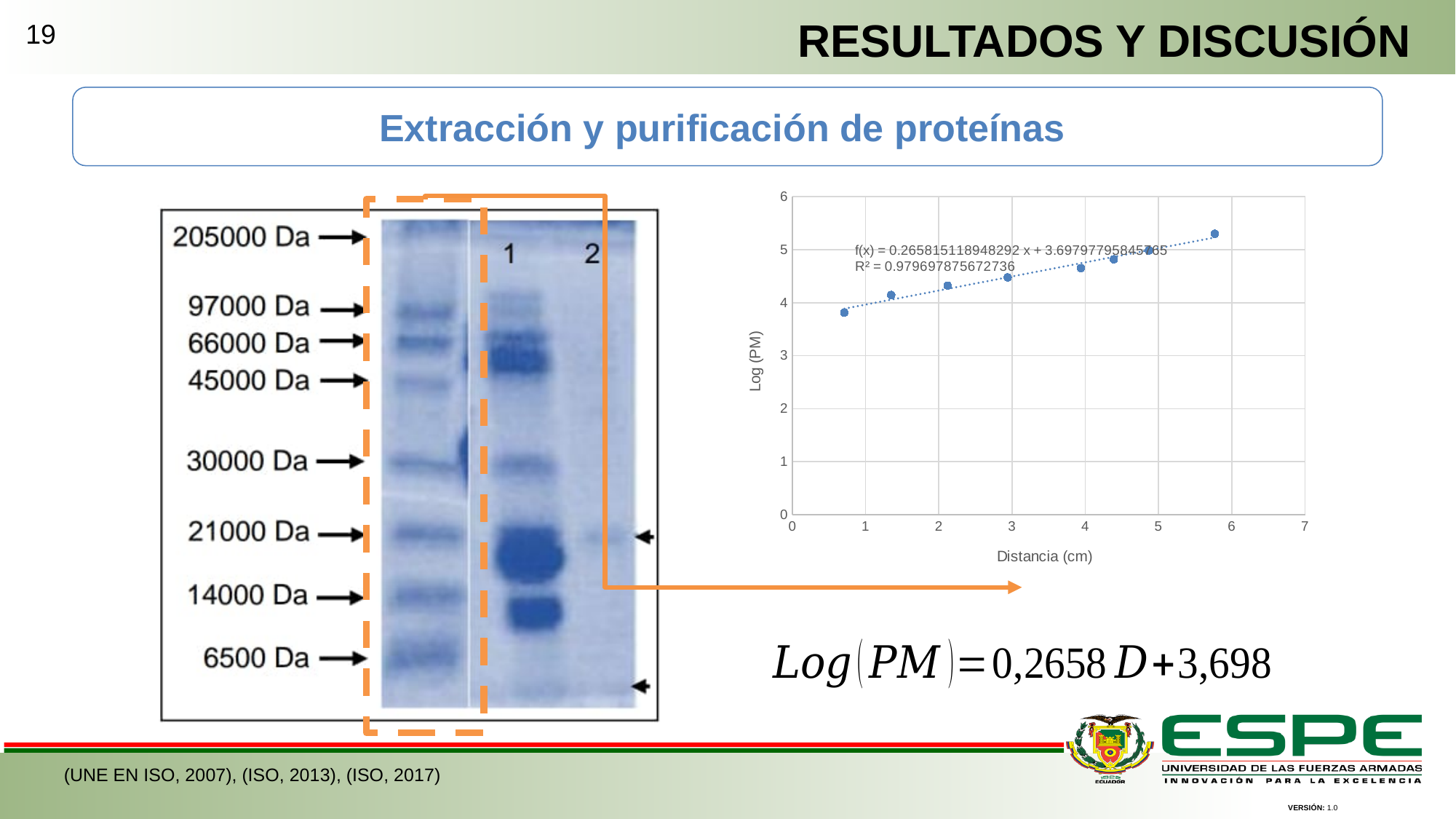
What kind of chart is shown on the right side of the slide? Scatter chart In the scatter chart, is the Log (PM) value of the point near 3 cm greater or less than 4? greater In the scatter chart, is the Log (PM) value of the point near 3 cm greater or less than 5? less What is the label of the x axis of the scatter chart? Distancia (cm) In the scatter chart, which point has the higher Log (PM): the leftmost point or the rightmost point? The rightmost point In the scatter chart, does Log (PM) rise or fall as Distancia (cm) increases? Rise What R² value is printed on the scatter chart? 0.979697875672736 In the scatter chart, is the Log (PM) value of the leftmost point greater or less than 4? less How many data points are plotted in the scatter chart? 8